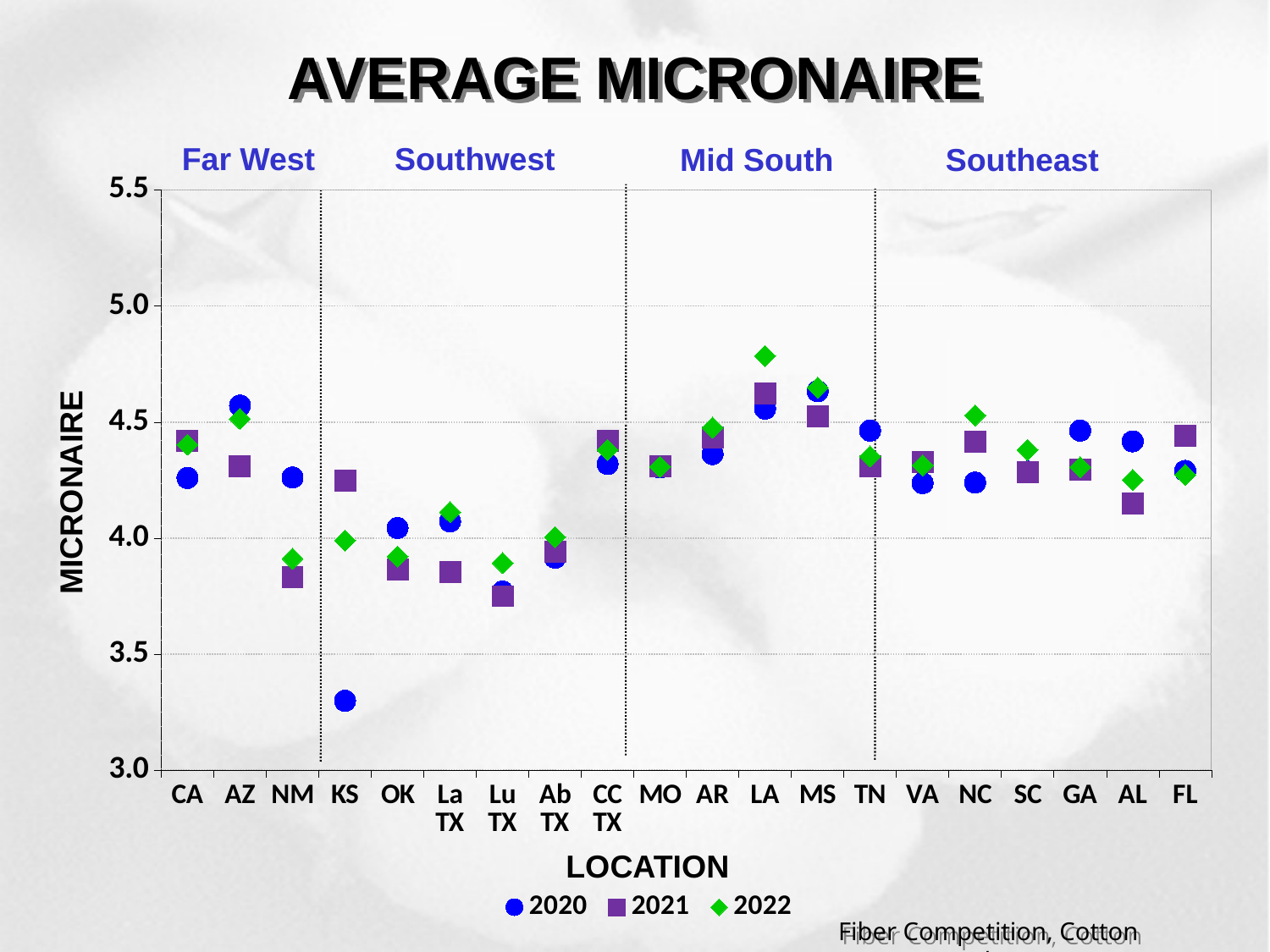
What is the title of the chart? AVERAGE MICRONAIRE How many locations are plotted along the x axis? 20 Is the 2022 value for LA greater or less than 4.5? greater Is the 2021 value for Lu TX greater or less than 4.0? less How many series does the legend list? 3 What kind of chart is shown on the slide? scatter chart For AZ, which is larger: the 2020 value or the 2021 value? 2020 Which location has the lowest 2020 value? KS Which location has the highest 2022 value? LA Is the 2020 value for CA greater or less than 4.0? greater For KS, which is larger: the 2020 value or the 2021 value? 2021